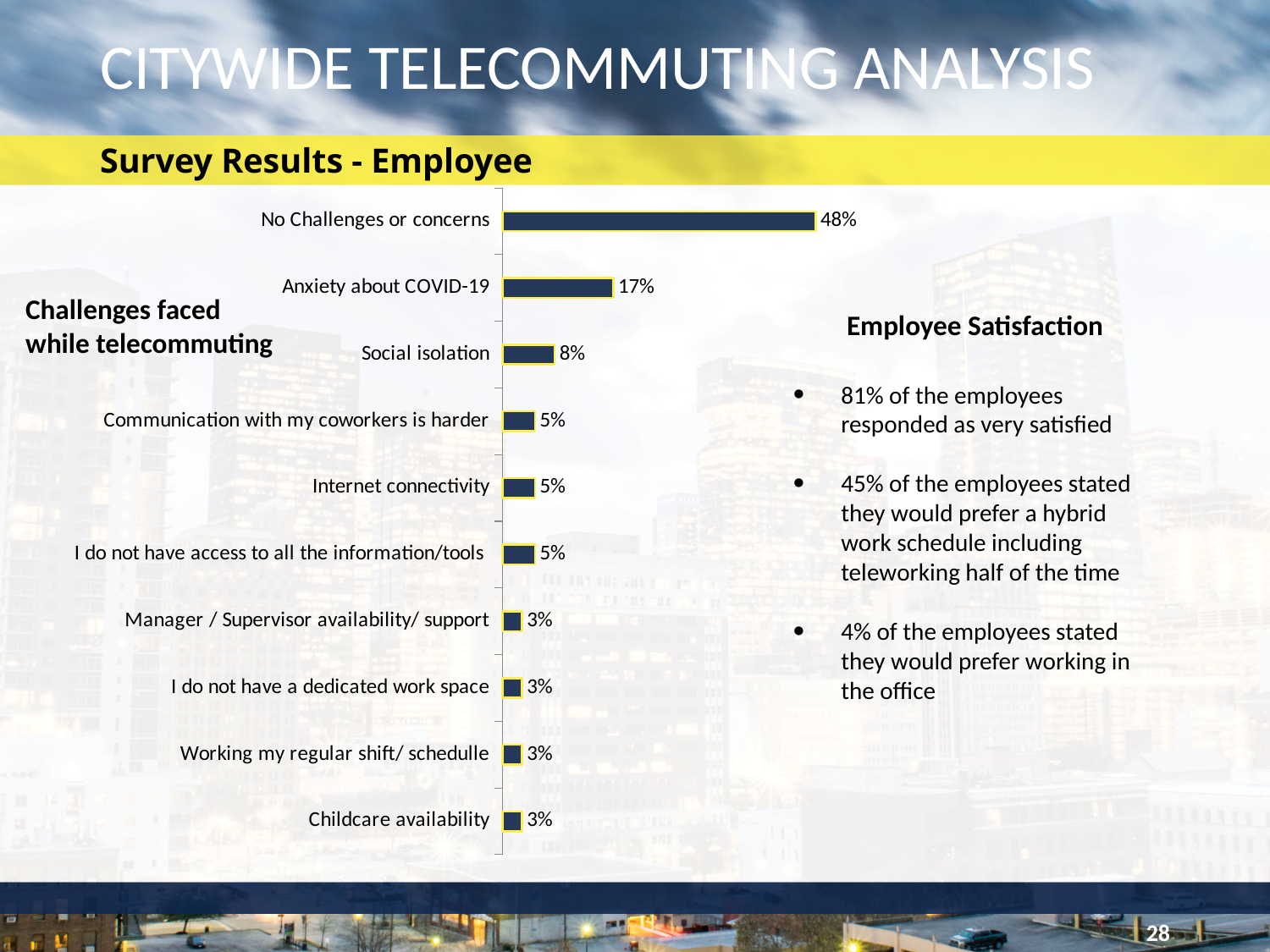
What is the title of the chart on the slide? Challenges faced while telecommuting What is the value for Social isolation? 8% What is the value for Anxiety about COVID-19? 17% How many categories in the chart have a value of 5%? 3 Which is larger, the value for Social isolation or the value for Internet connectivity? Social isolation What is the difference between the values for Anxiety about COVID-19 and Social isolation? 9% Which challenge category has the highest value? No Challenges or concerns What percentage of employees reported no challenges or concerns while telecommuting? 48% How many categories are shown in the chart? 10 What kind of chart is shown on the slide? Bar chart What is the value for Childcare availability? 3% What is the difference between the values for No Challenges or concerns and Anxiety about COVID-19? 31%